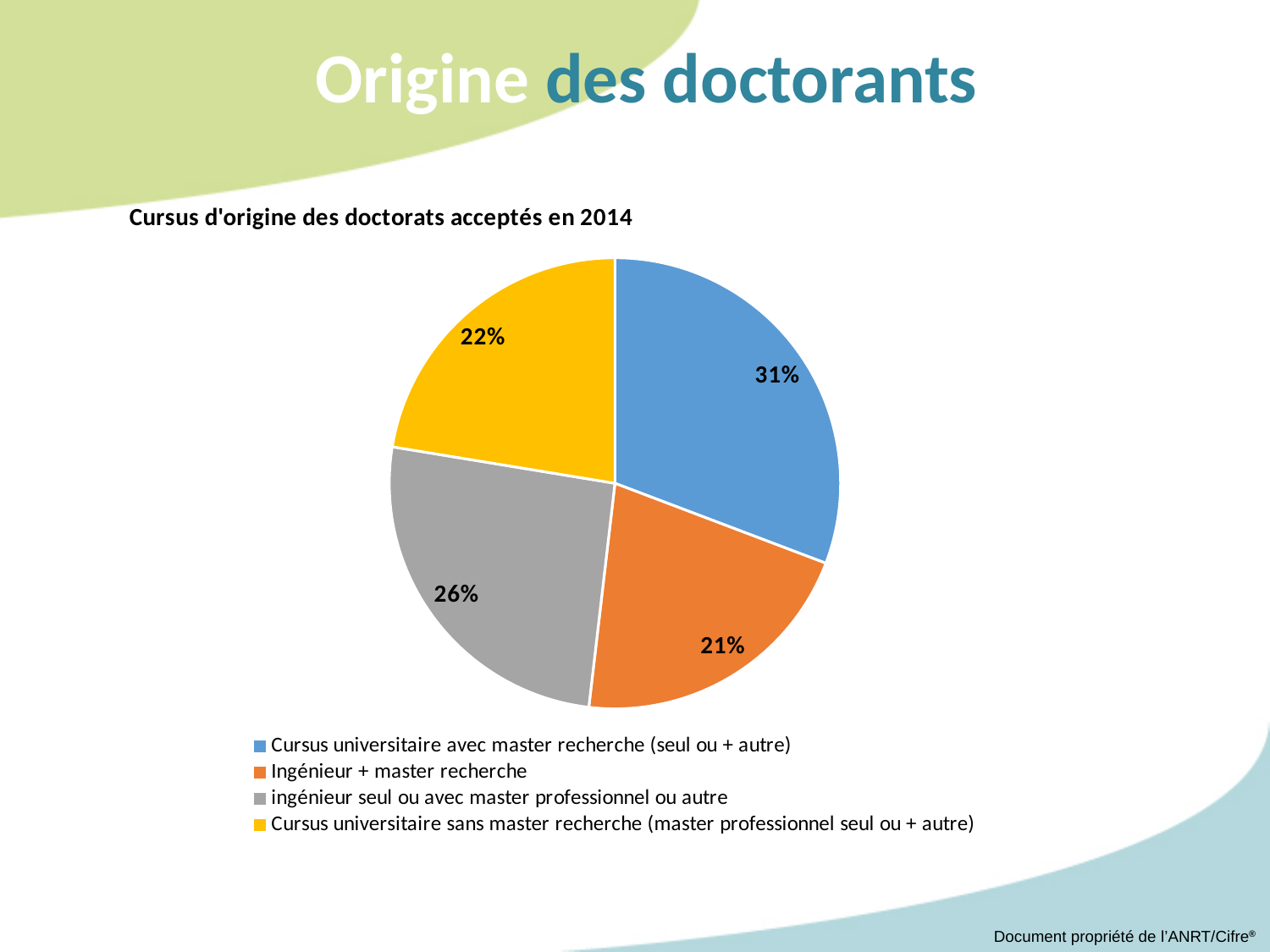
What share of the pie is 'Cursus universitaire avec master recherche (seul ou + autre)'? 31% How many categories does the pie chart have? 4 What share of the pie is 'Ingénieur + master recherche'? 21% Which is larger: the share for 'ingénieur seul ou avec master professionnel ou autre' or the share for 'Cursus universitaire sans master recherche (master professionnel seul ou + autre)'? ingénieur seul ou avec master professionnel ou autre Which category has the largest share of the pie? Cursus universitaire avec master recherche (seul ou + autre) What is the difference in percentage points between 'Cursus universitaire avec master recherche (seul ou + autre)' and 'Ingénieur + master recherche'? 10 What share of the pie is 'Cursus universitaire sans master recherche (master professionnel seul ou + autre)'? 22% What colour is the slice for 'Ingénieur + master recherche'? orange What type of chart is shown on the slide? pie chart Which category has the smallest share of the pie? Ingénieur + master recherche What is the title of the chart? Cursus d'origine des doctorats acceptés en 2014 What share of the pie is 'ingénieur seul ou avec master professionnel ou autre'? 26%